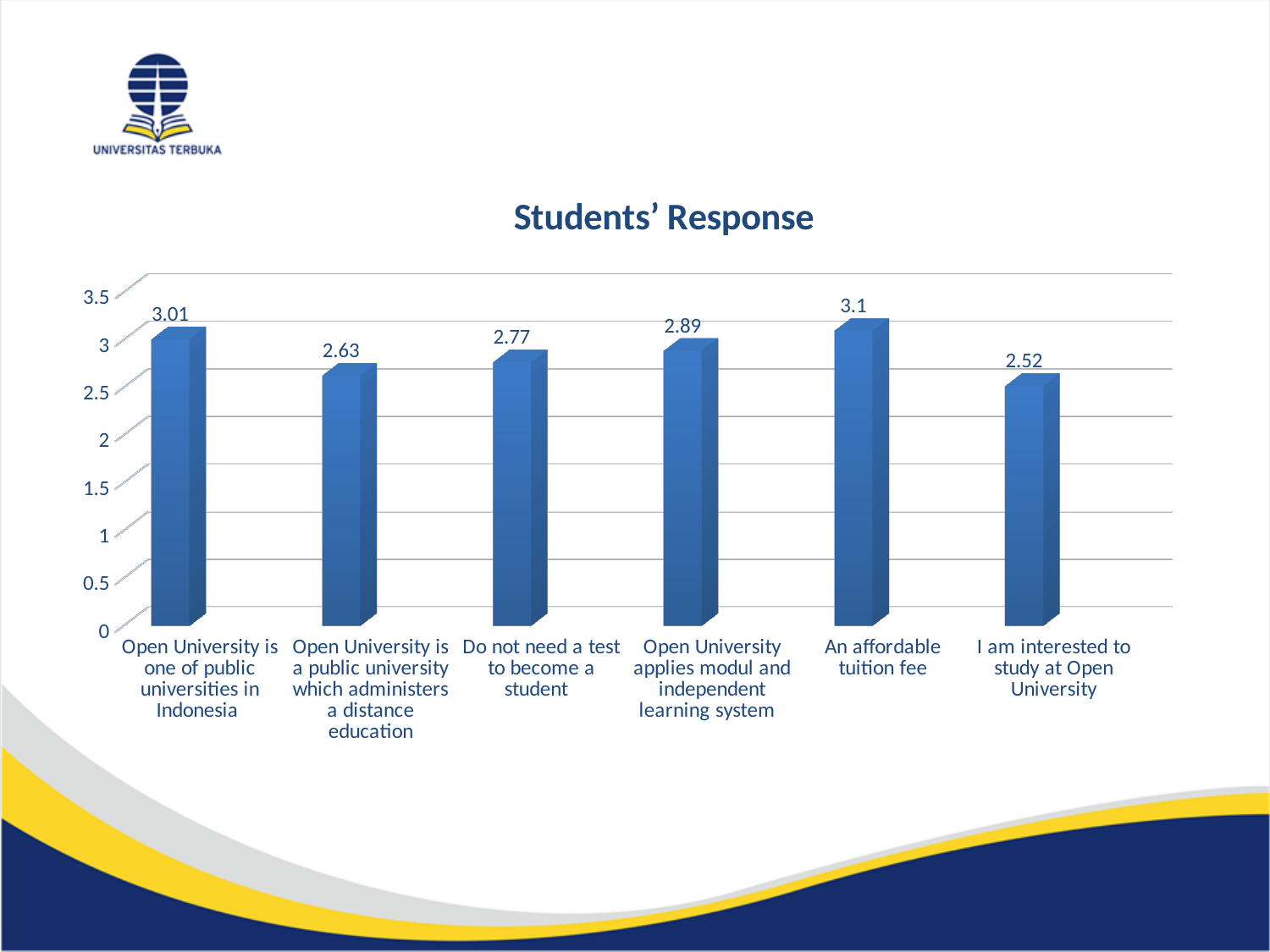
What is the difference between the values for "Open University is one of public universities in Indonesia" and "Open University is a public university which administers a distance education"? 0.38 How many categories are shown in the chart? 6 Is the value for "Open University is one of public universities in Indonesia" greater or less than 2.5? greater What is the title of the chart? Students' Response Which category has the lowest value? I am interested to study at Open University Which is larger: the value for "Open University applies modul and independent learning system" or the value for "Open University is a public university which administers a distance education"? Open University applies modul and independent learning system What is the value for "An affordable tuition fee"? 3.1 What is the difference between the values for "An affordable tuition fee" and "I am interested to study at Open University"? 0.58 What kind of chart is shown on the slide? bar chart What is the value for "Do not need a test to become a student"? 2.77 What is the value for "I am interested to study at Open University"? 2.52 Which category has the highest value? An affordable tuition fee